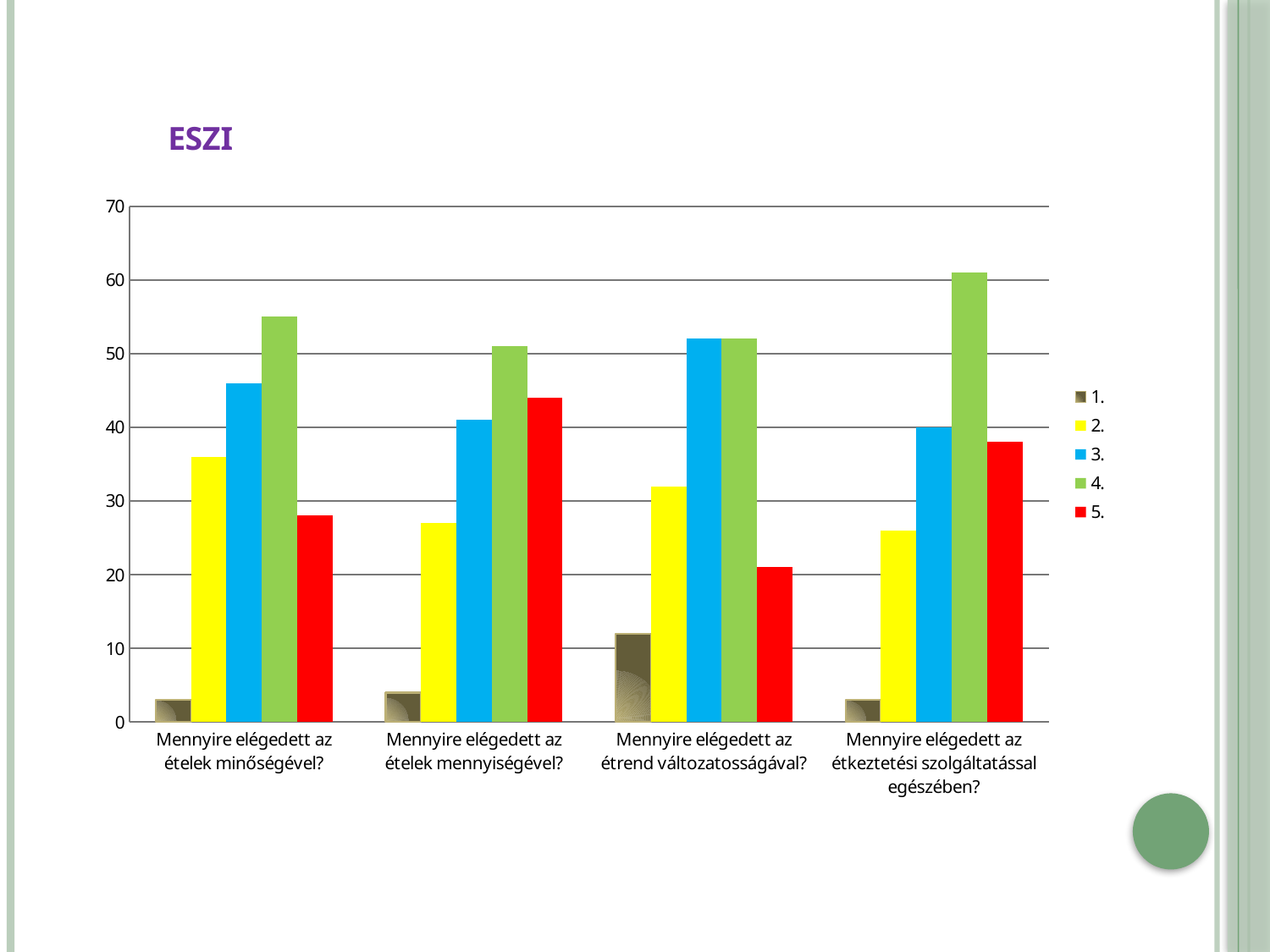
For which category does series 4. reach its highest value? Mennyire elégedett az étkeztetési szolgáltatással egészében? For "Mennyire elégedett az ételek minőségével?", which is larger: series 3. or series 5.? 3. What kind of chart is shown on the slide? bar chart Is the value of series 5. for "Mennyire elégedett az étrend változatosságával?" greater or less than 30? less How many categories are shown on the x axis of the chart? 4 Is the value of series 2. for "Mennyire elégedett az ételek minőségével?" greater or less than 30? greater Is the value of series 1. for "Mennyire elégedett az étrend változatosságával?" greater or less than 10? greater Which series is highest for the category "Mennyire elégedett az ételek minőségével?"? 4. What is the title of the chart? ESZI Which series is lowest for the category "Mennyire elégedett az étrend változatosságával?"? 1. Which colour represents series 5. in the legend? red How many series does the chart's legend list? 5